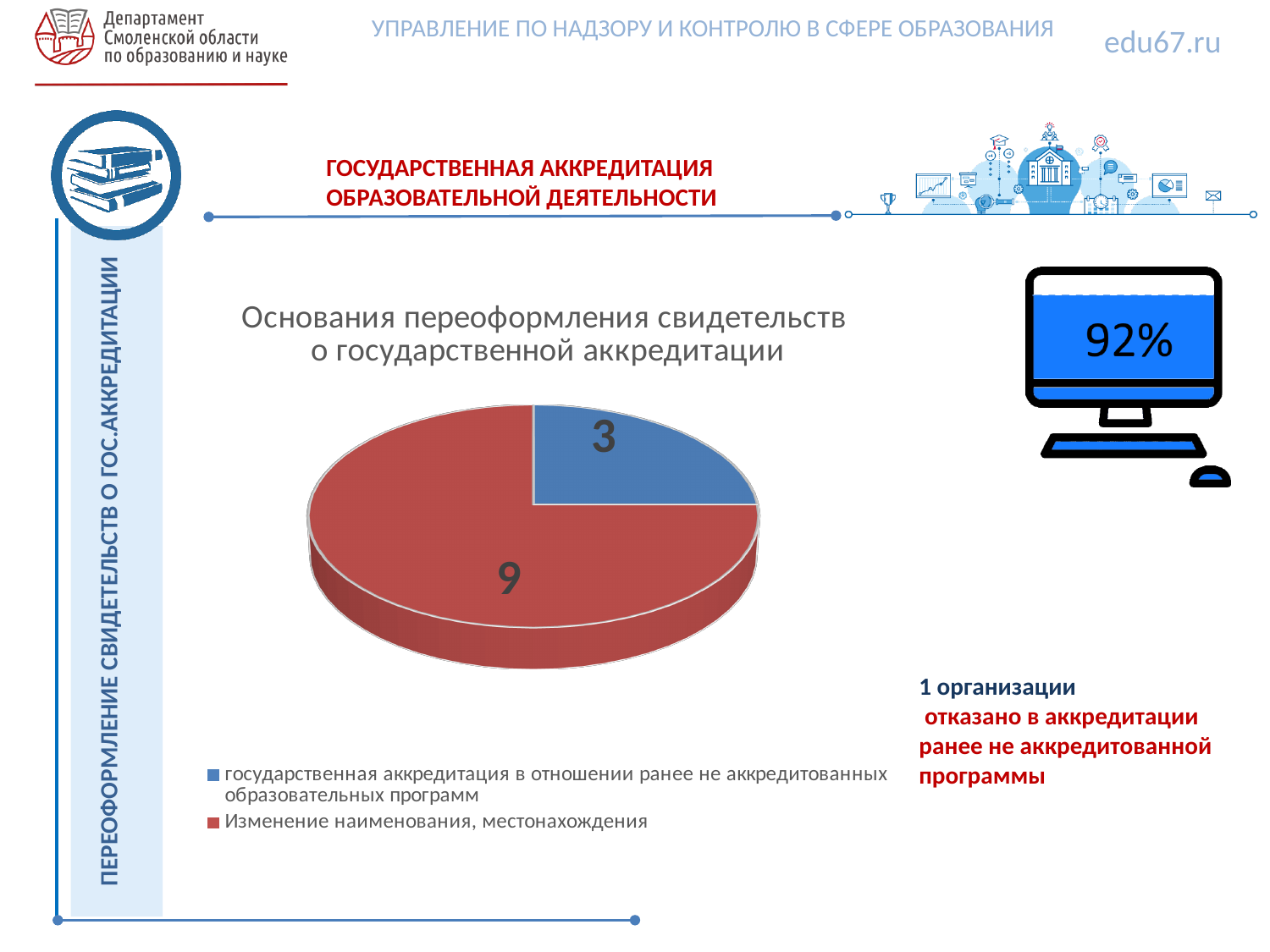
What is the difference between the value for "Изменение наименования, местонахождения" and the value for "государственная аккредитация в отношении ранее не аккредитованных образовательных программ"? 6 How many slices does the pie chart have? 2 How many entries does the legend of the pie chart list? 2 What is the value for "государственная аккредитация в отношении ранее не аккредитованных образовательных программ"? 3 What colour is the slice for "Изменение наименования, местонахождения"? red What is the title of the pie chart? Основания переоформления свидетельств о государственной аккредитации What share of the pie does "Изменение наименования, местонахождения" represent? 75% What is the value for "Изменение наименования, местонахождения"? 9 Which category has the largest slice of the pie? Изменение наименования, местонахождения Which category has the smallest slice of the pie? государственная аккредитация в отношении ранее не аккредитованных образовательных программ What type of chart is shown on the slide? pie chart Which is larger: the value for "Изменение наименования, местонахождения" or the value for "государственная аккредитация в отношении ранее не аккредитованных образовательных программ"? Изменение наименования, местонахождения